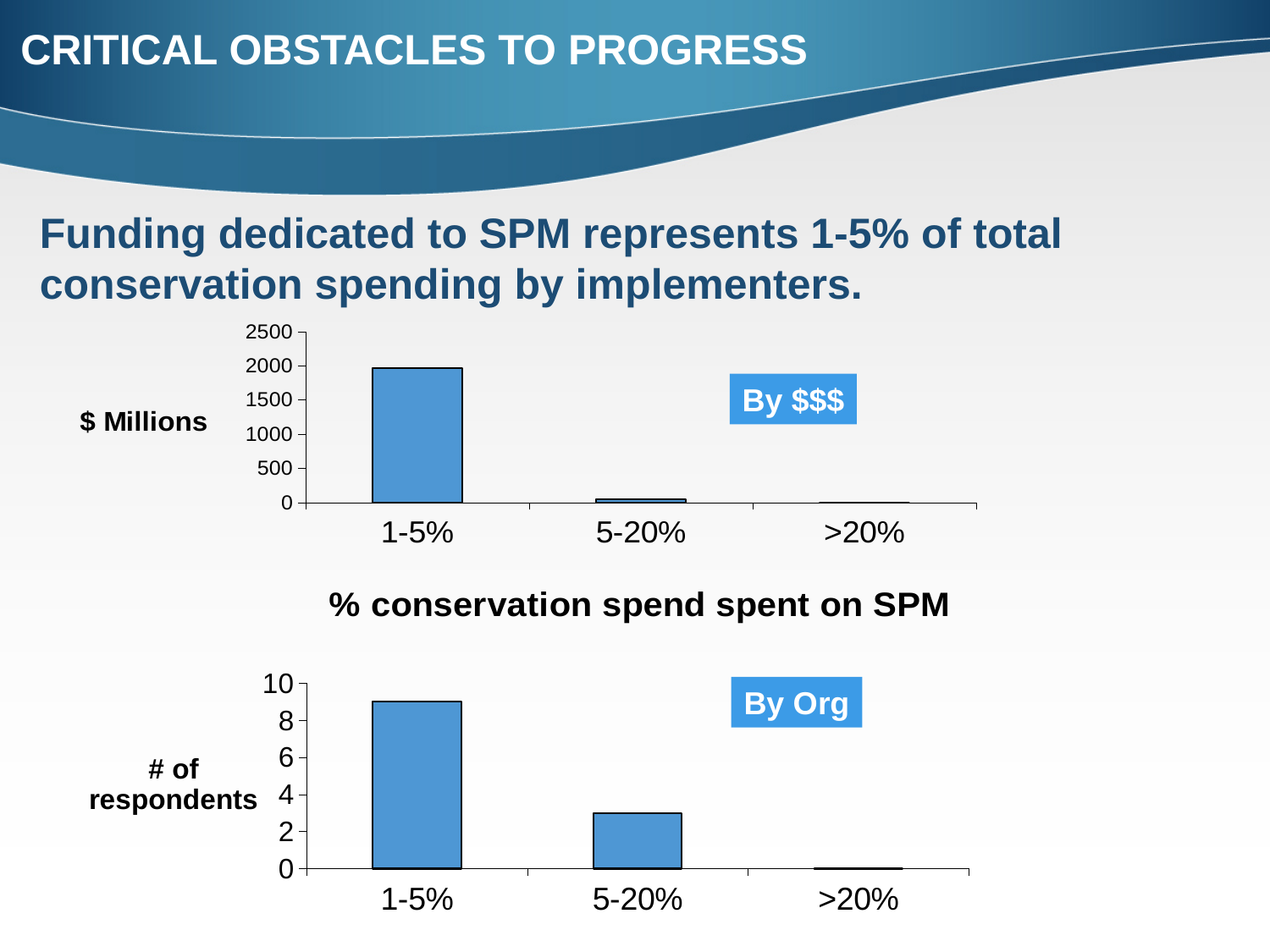
In the top chart (By $$$), which is larger, the value for 1-5% or the value for 5-20%? 1-5% What kind of chart is the top chart (By $$$)? bar chart What is the y-axis label of the bottom chart (By Org)? # of respondents In the bottom chart (By Org), is the value for 1-5% greater or less than 8? greater In the bottom chart (By Org), is the value for 5-20% greater or less than 4? less In the top chart (By $$$), which category has the highest value? 1-5% In the bottom chart (By Org), which is larger, the value for 5-20% or the value for >20%? 5-20% In the top chart (By $$$), how many categories are shown on the x axis? 3 In the bottom chart (By Org), which category has the highest value? 1-5% In the top chart (By $$$), do the values rise or fall from left to right along the x axis? fall In the top chart (By $$$), is the value for 1-5% greater or less than 1500? greater